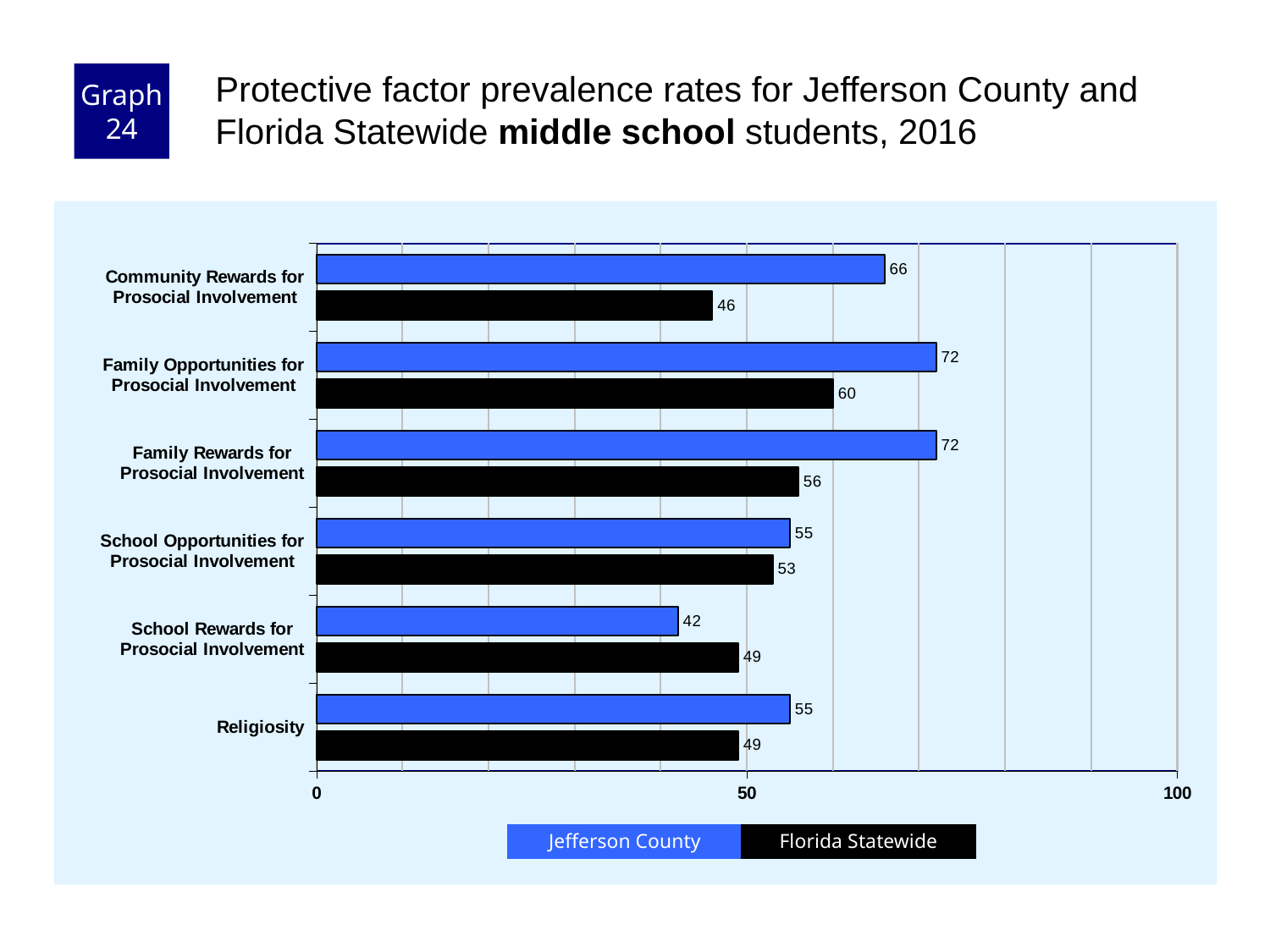
For School Rewards for Prosocial Involvement, which is larger: the Jefferson County value or the Florida Statewide value? Florida Statewide What is the Jefferson County value for Community Rewards for Prosocial Involvement? 66 How many categories are shown on the chart? 6 How many series does the legend list? 2 What kind of chart is shown on the slide? Bar chart Which category has the highest Florida Statewide value? Family Opportunities for Prosocial Involvement What is the Florida Statewide value for Family Opportunities for Prosocial Involvement? 60 What is the difference between the Jefferson County and Florida Statewide values for Community Rewards for Prosocial Involvement? 20 Which colour represents Florida Statewide in the chart? Black What is the Florida Statewide value for Religiosity? 49 Which category has the lowest Jefferson County value? School Rewards for Prosocial Involvement What is the Jefferson County value for School Rewards for Prosocial Involvement? 42